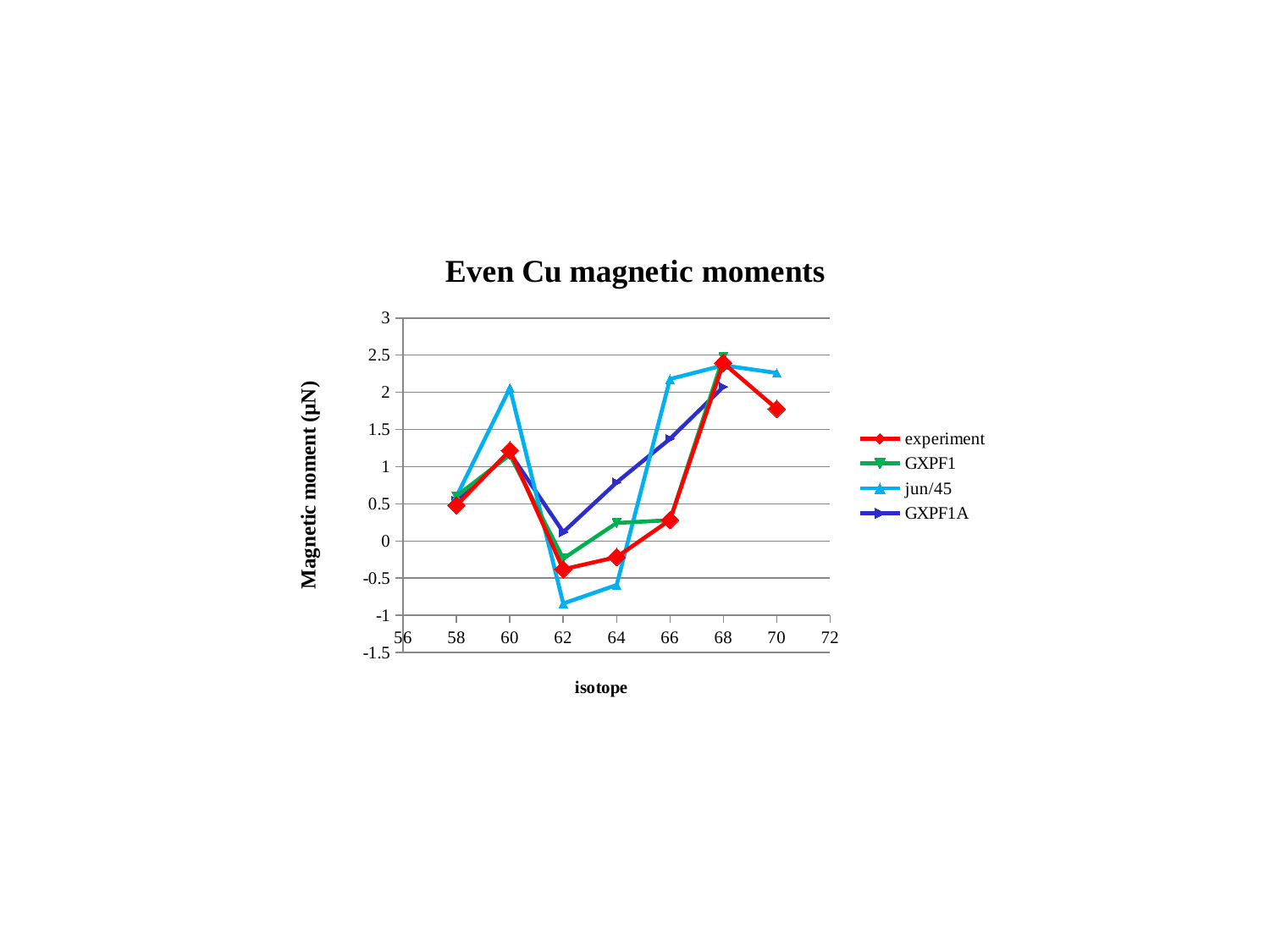
At which isotope does the experiment series reach its highest value? 68 What is the title of the chart? Even Cu magnetic moments Is the experiment value at isotope 68 greater or less than 2? greater Is the jun/45 value at isotope 62 greater or less than -0.5? less What is the label of the y axis? Magnetic moment (μN) At isotope 60, which series has the larger value, jun/45 or experiment? jun/45 Is the GXPF1A value at isotope 66 greater or less than 1? greater At which isotope does the jun/45 series reach its lowest value? 62 How many data points does the experiment series have? 7 What kind of chart is shown on the slide? line chart How many series does the legend list? 4 At isotope 64, which series has the larger value, GXPF1A or experiment? GXPF1A